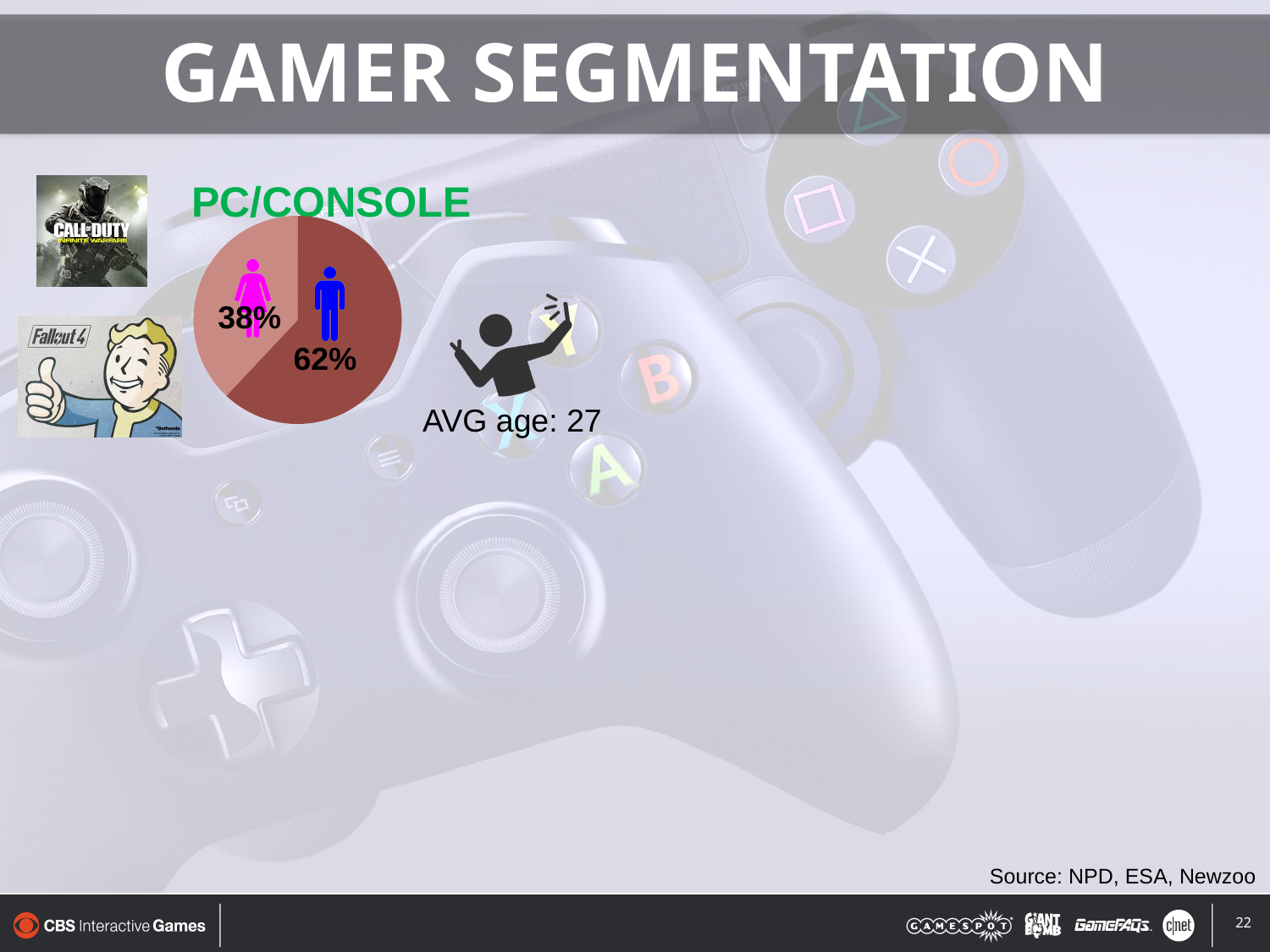
What share of the pie chart is labelled with the male icon? 62% Which slice of the pie chart is the largest? 62% (male icon) How many slices does the pie chart have? 2 Is the slice with the female icon greater or less than 50% of the pie? less What share of the pie chart is labelled with the female icon? 38% What average age is stated next to the pie chart? 27 What heading appears above the pie chart? PC/CONSOLE Which slice of the pie chart is larger, the one with the female icon or the one with the male icon? male icon What kind of chart is shown under the PC/CONSOLE heading? pie chart Which slice of the pie chart is the smallest? 38% (female icon) What is the difference in percentage points between the two slices of the pie chart? 24